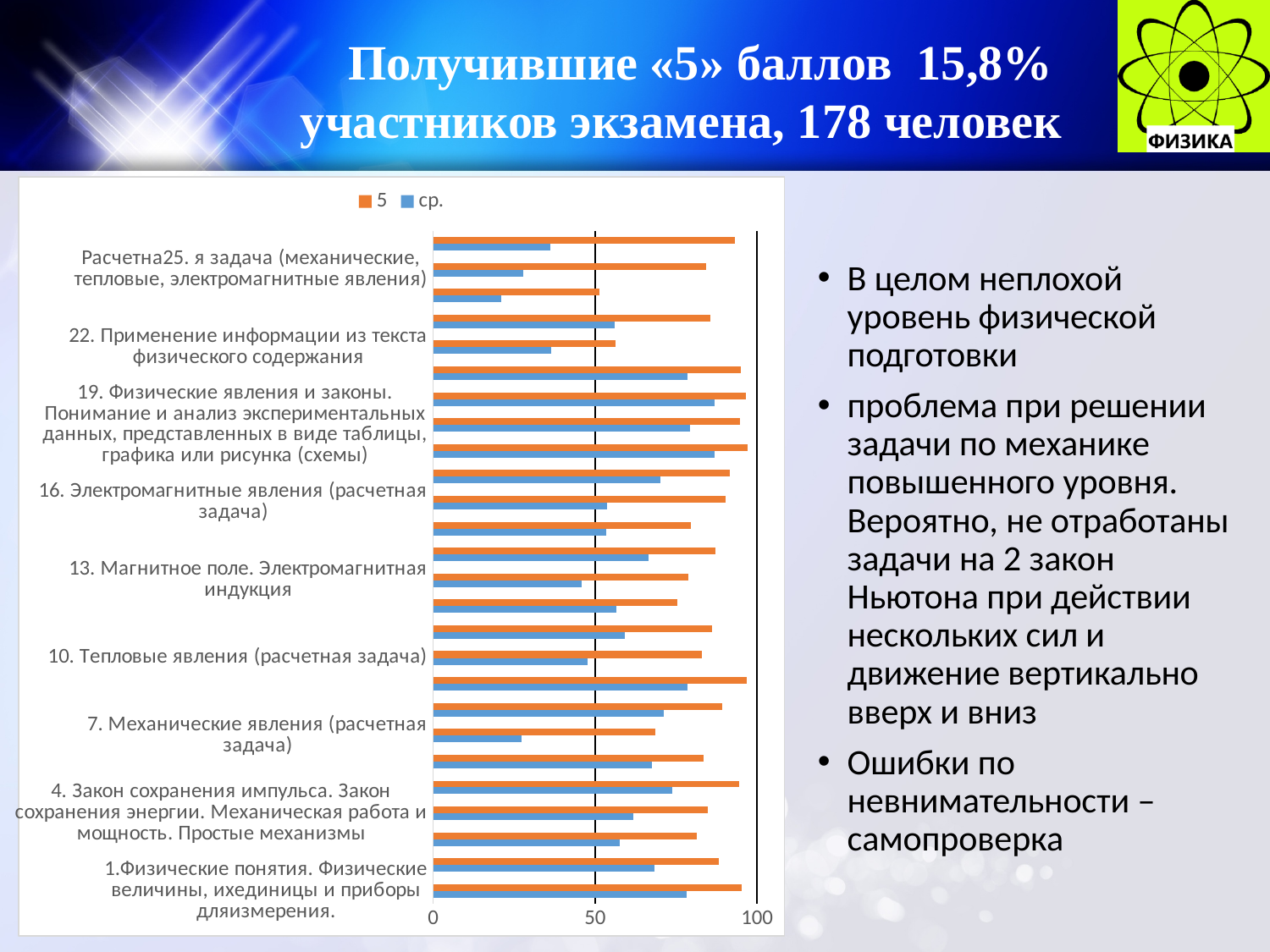
Which colour represents the series "5" in the chart? orange Is the "ср." value for "13. Магнитное поле. Электромагнитная индукция" greater or less than 50? less Is the "5" value for "16. Электромагнитные явления (расчетная задача)" greater or less than 50? greater Is the "ср." value for "22. Применение информации из текста физического содержания" greater or less than 50? less For "10. Тепловые явления (расчетная задача)", which series has the larger value, "5" or "ср."? 5 What are the two series named in the chart legend? 5 and ср. What kind of chart is shown on the slide? bar chart How many series does the chart legend list? 2 For "7. Механические явления (расчетная задача)", which series has the larger value, "5" or "ср."? 5